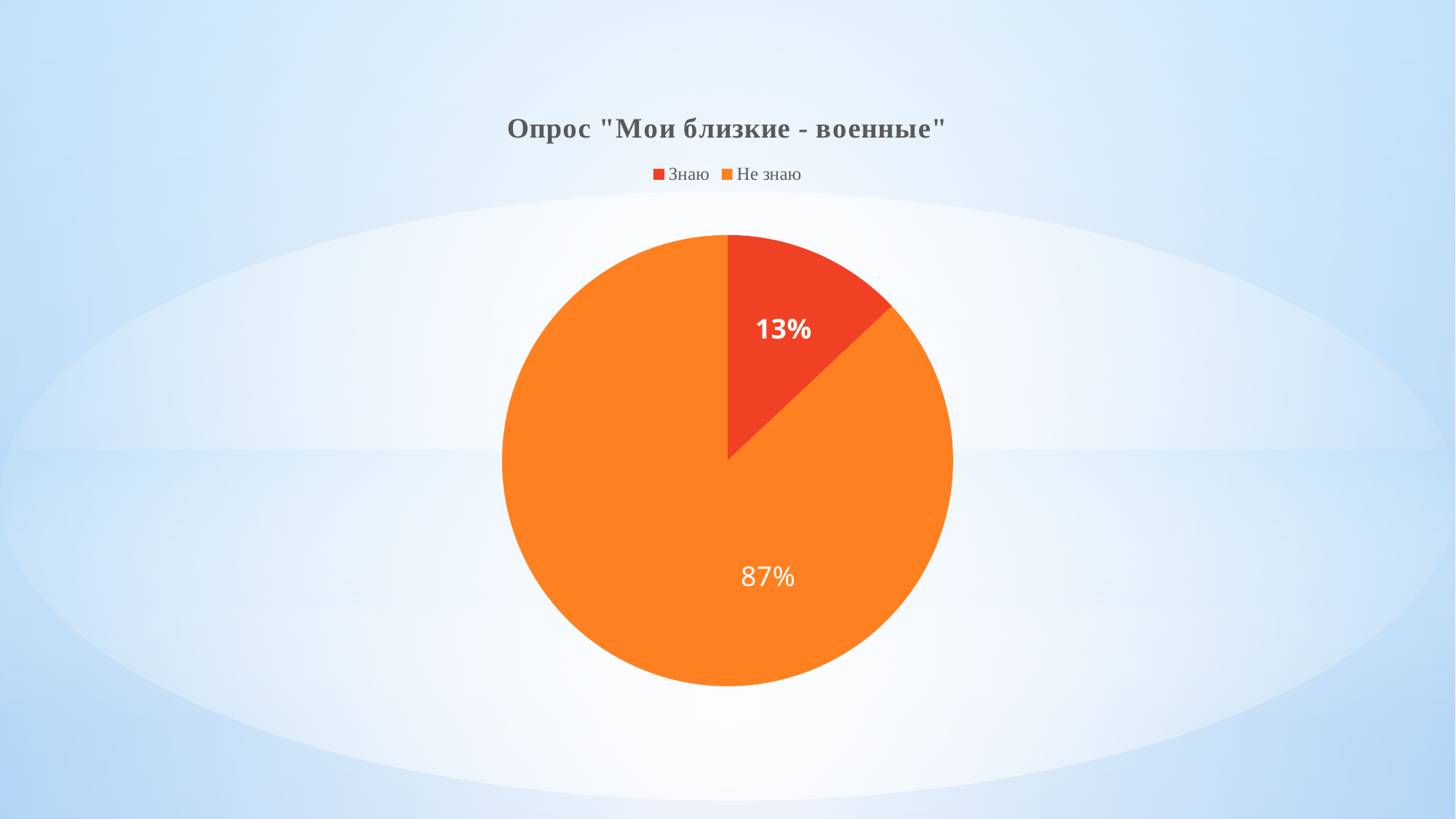
Which slice is the largest? Не знаю How many slices does the pie chart have? 2 Which is larger, "Знаю" or "Не знаю"? Не знаю What share of the pie does "Не знаю" take? 87% What is the difference in percentage points between "Не знаю" and "Знаю"? 74 Which legend entry is shown in red? Знаю Which slice is the smallest? Знаю What is the title of the chart? Опрос "Мои близкие - военные" How many entries does the legend list? 2 What kind of chart is shown on the slide? pie chart What share of the pie does "Знаю" take? 13%